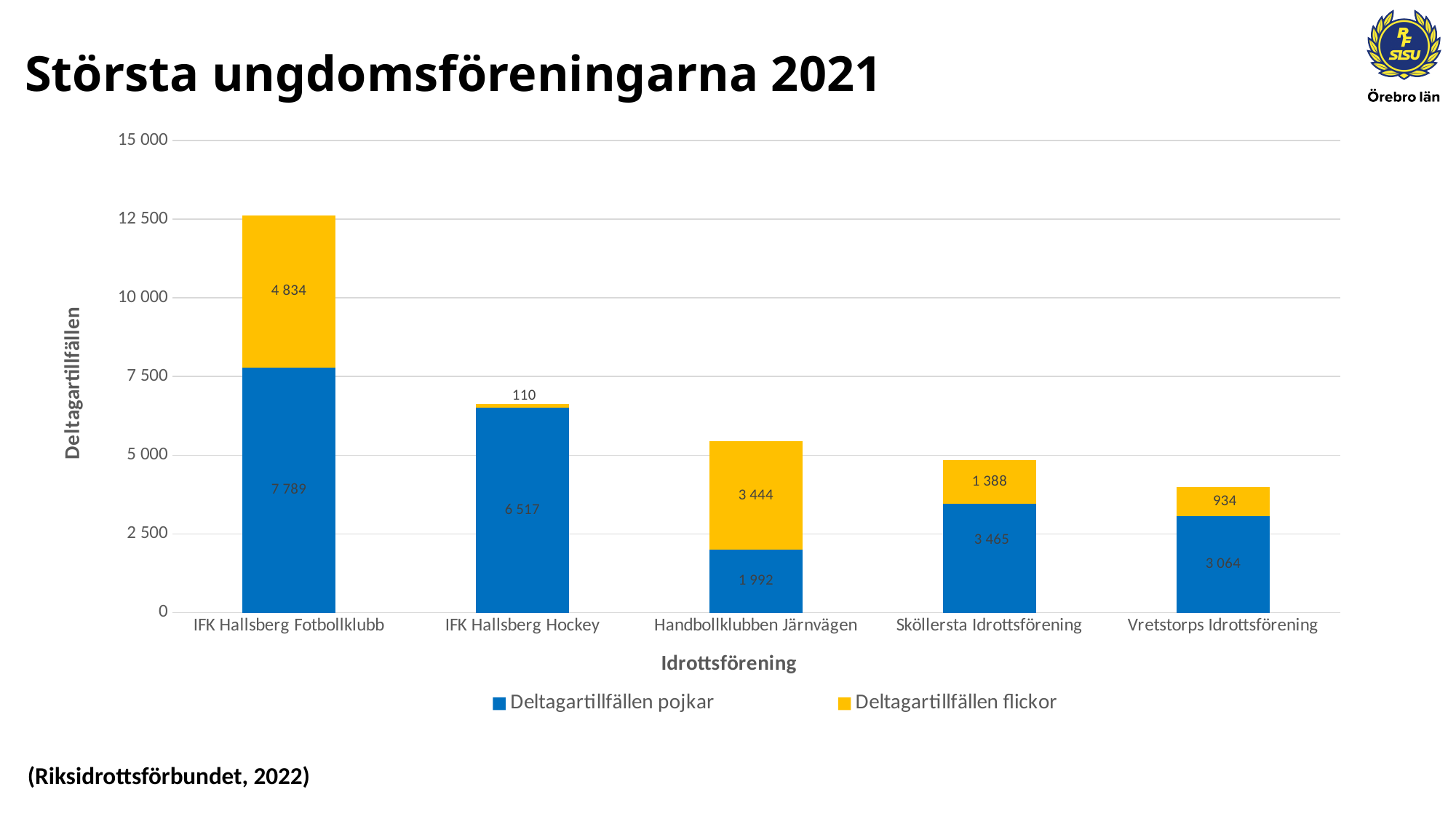
What is the difference between Deltagartillfällen pojkar for Sköllersta Idrottsförening and Vretstorps Idrottsförening? 401 Is the total stacked bar for IFK Hallsberg Fotbollklubb greater or less than 12 500? greater What is the value of Deltagartillfällen flickor for Handbollklubben Järnvägen? 3 444 What is the total of the stacked bar for Sköllersta Idrottsförening? 4 853 What is the value of Deltagartillfällen flickor for IFK Hallsberg Hockey? 110 How many series does the legend list? 2 What kind of chart is shown on the slide? Stacked bar chart Which Idrottsförening has the highest value for Deltagartillfällen flickor? IFK Hallsberg Fotbollklubb Which Idrottsförening has the lowest value for Deltagartillfällen pojkar? Handbollklubben Järnvägen Which is larger for Handbollklubben Järnvägen: Deltagartillfällen pojkar or Deltagartillfällen flickor? Deltagartillfällen flickor How many Idrottsförening categories are shown on the x axis? 5 What is the value of Deltagartillfällen pojkar for IFK Hallsberg Fotbollklubb? 7 789